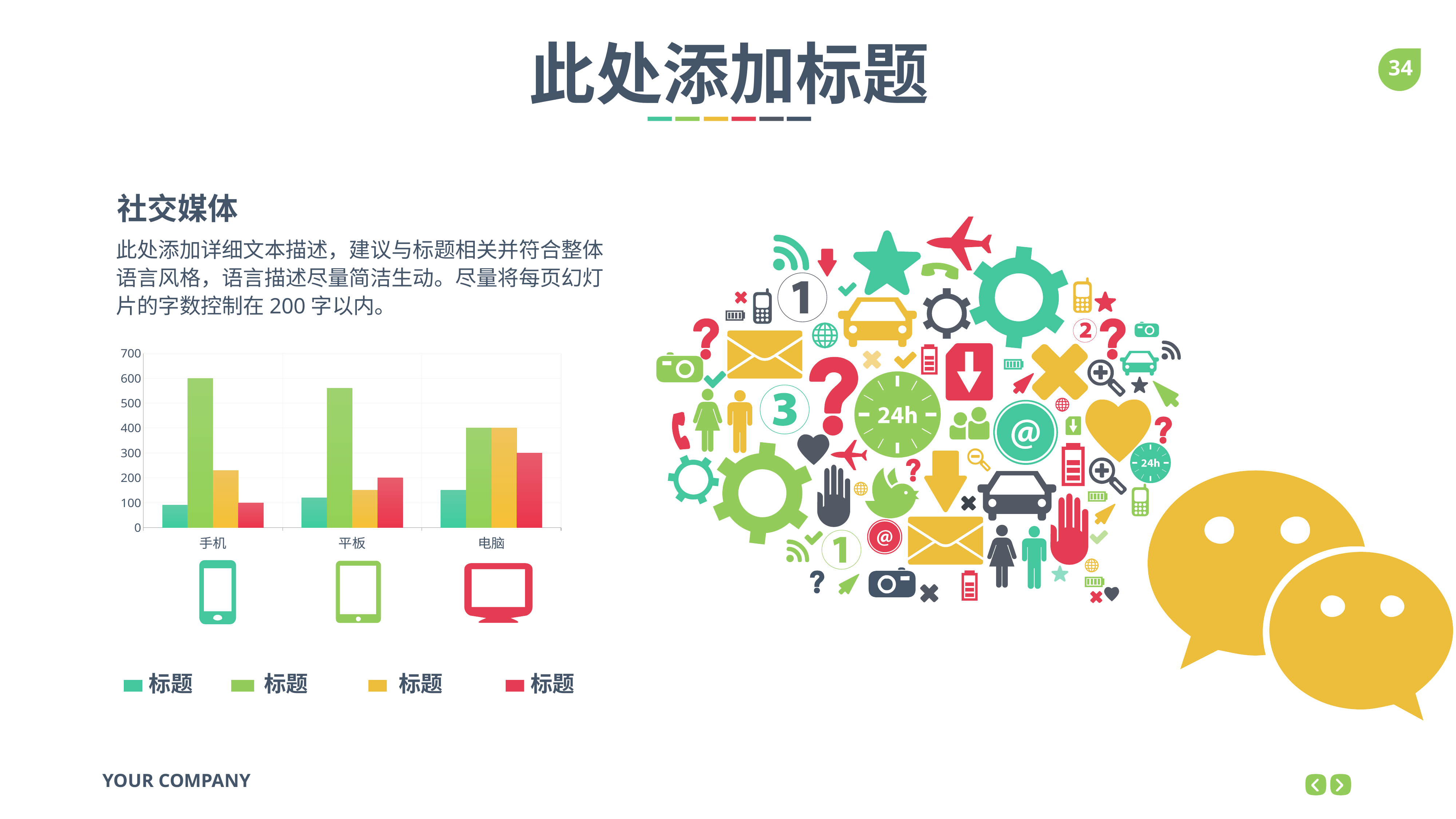
Which coloured bar is the lowest in the 手机 group? teal How many categories are shown on the x axis of the bar chart? 3 What is the value of the green bar for 手机? 600 What is the value of the red bar for 电脑? 300 Which category has the tallest green bar? 手机 What is the value of the red bar for 手机? 100 What kind of chart is shown on the slide? bar chart Is the value of the green bar for 平板 greater or less than 500? greater How many series does the legend of the bar chart list? 4 What is the highest value shown on the vertical axis of the bar chart? 700 Which is larger, the red bar for 电脑 or the red bar for 平板? 电脑